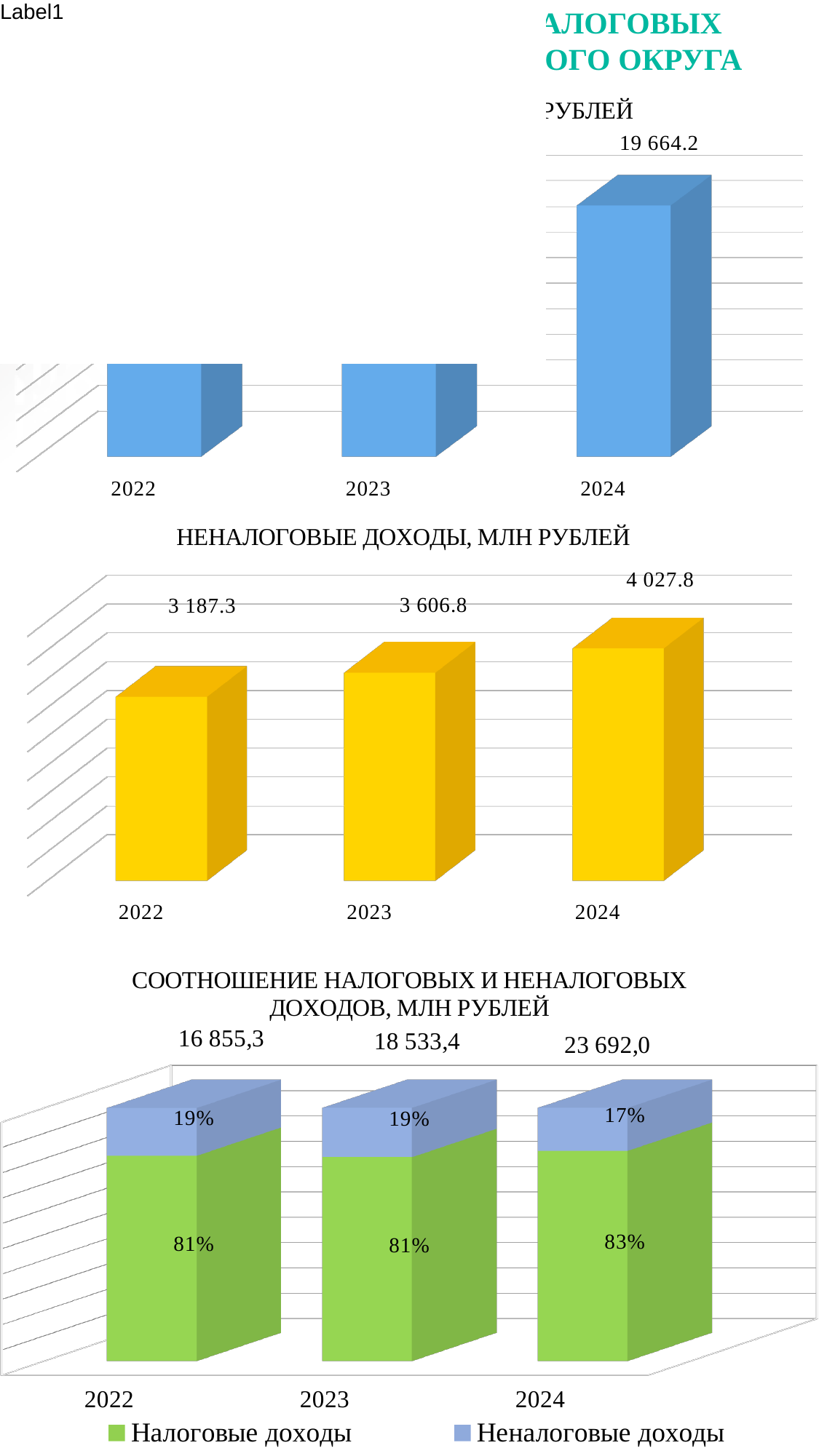
In the chart titled 'НЕНАЛОГОВЫЕ ДОХОДЫ, МЛН РУБЛЕЙ', do the values rise or fall from 2022 to 2024? rise In the top chart, which year has the highest bar? 2024 In the chart titled 'НЕНАЛОГОВЫЕ ДОХОДЫ, МЛН РУБЛЕЙ', what is the difference between the 2024 and 2023 values? 421.0 In the top chart, what is the value for 2024? 19 664.2 In the chart titled 'НЕНАЛОГОВЫЕ ДОХОДЫ, МЛН РУБЛЕЙ', what is the value for 2022? 3 187.3 In the chart titled 'НЕНАЛОГОВЫЕ ДОХОДЫ, МЛН РУБЛЕЙ', which year has the lowest value? 2022 In the chart titled 'СООТНОШЕНИЕ НАЛОГОВЫХ И НЕНАЛОГОВЫХ ДОХОДОВ, МЛН РУБЛЕЙ', how many series does the legend list? 2 In the chart titled 'СООТНОШЕНИЕ НАЛОГОВЫХ И НЕНАЛОГОВЫХ ДОХОДОВ, МЛН РУБЛЕЙ', what percentage is shown for Неналоговые доходы in 2024? 17% In the chart titled 'СООТНОШЕНИЕ НАЛОГОВЫХ И НЕНАЛОГОВЫХ ДОХОДОВ, МЛН РУБЛЕЙ', what is the total shown above the 2024 bar? 23 692,0 In the chart titled 'НЕНАЛОГОВЫЕ ДОХОДЫ, МЛН РУБЛЕЙ', what is the value for 2023? 3 606.8 What kind of chart is the chart titled 'СООТНОШЕНИЕ НАЛОГОВЫХ И НЕНАЛОГОВЫХ ДОХОДОВ, МЛН РУБЛЕЙ'? stacked bar chart In the top chart, how many bars are plotted? 3